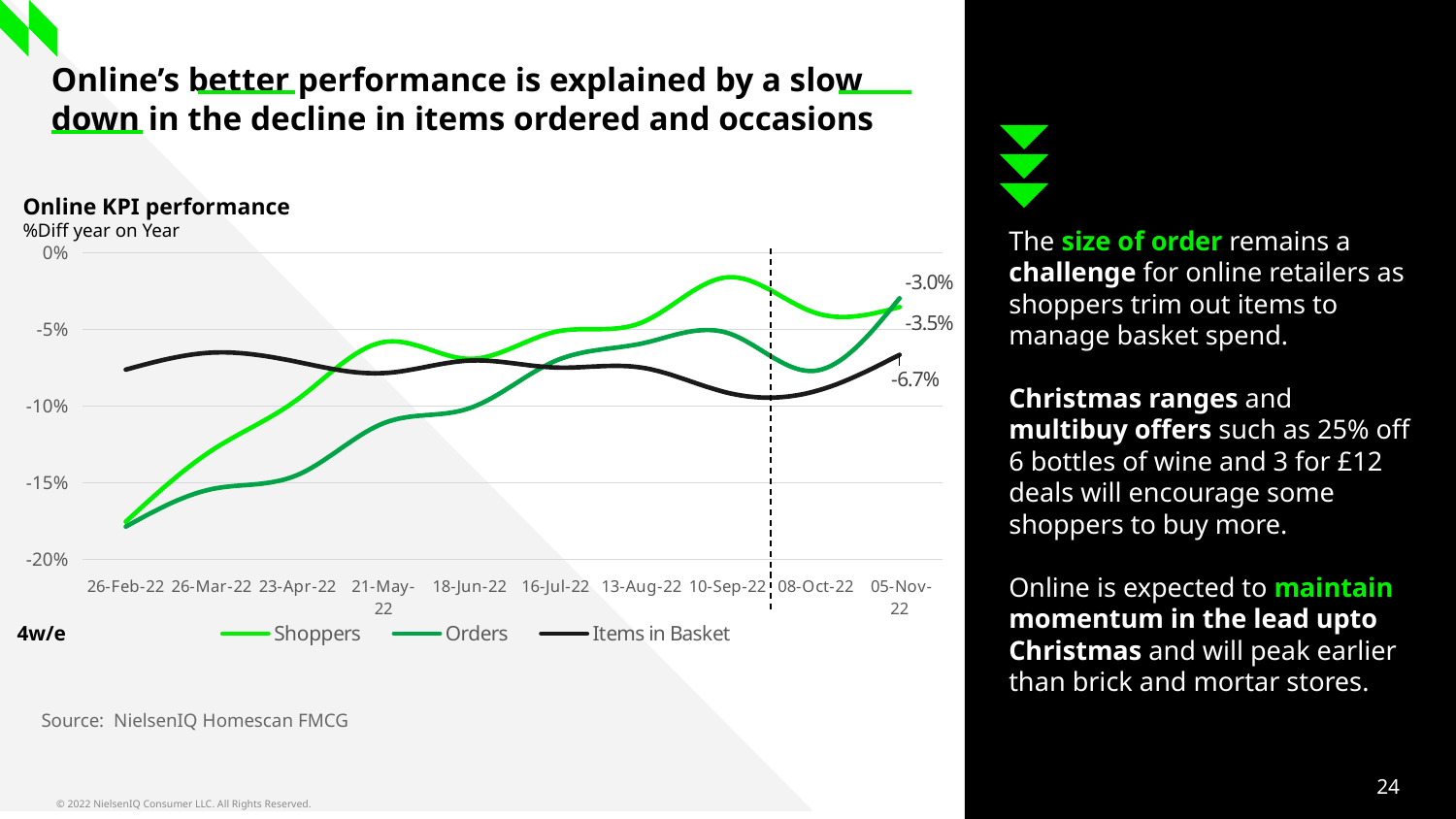
What is the value for Shoppers at 05-Nov-22 in the Online KPI performance chart? -3.5% What kind of chart is the Online KPI performance chart? line chart What is the difference between the Shoppers and Items in Basket values at 05-Nov-22 in the Online KPI performance chart? 3.2 percentage points At 05-Nov-22, which is larger in the Online KPI performance chart: the Orders value or the Items in Basket value? Orders What is the value for Items in Basket at 05-Nov-22 in the Online KPI performance chart? -6.7% What is the value for Orders at 05-Nov-22 in the Online KPI performance chart? -3.0% What is the source cited for the Online KPI performance chart? NielsenIQ Homescan FMCG How many dates are shown on the x axis of the Online KPI performance chart? 10 How many series does the legend of the Online KPI performance chart list? 3 Which series has the lowest value at 05-Nov-22 in the Online KPI performance chart? Items in Basket Does the Shoppers line in the Online KPI performance chart rise or fall overall from 26-Feb-22 to 05-Nov-22? rise Is the value for Shoppers at 26-Feb-22 greater or less than -15% in the Online KPI performance chart? less